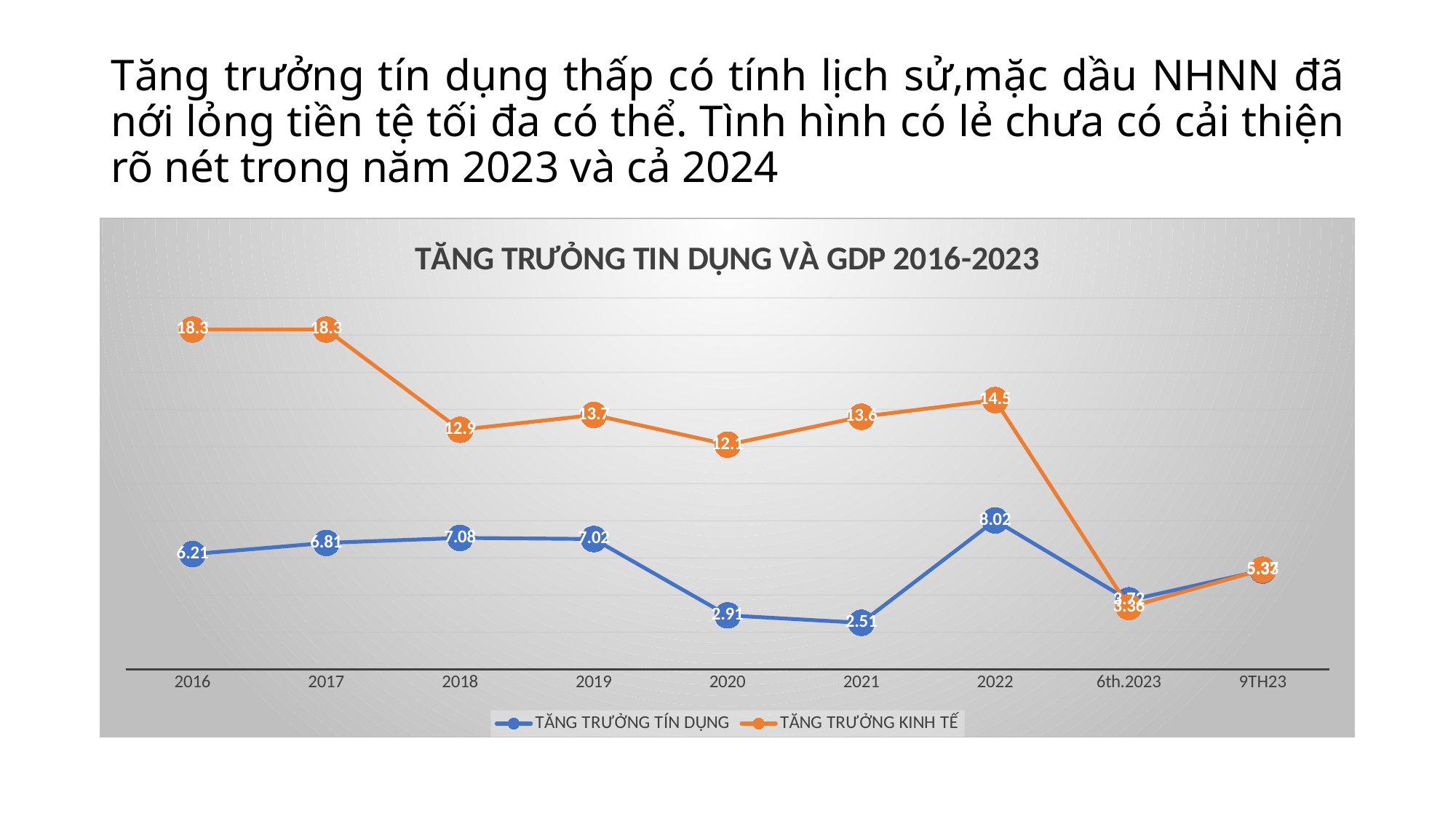
Which is larger, TĂNG TRƯỞNG TÍN DỤNG in 2018 or in 2019? 2018 How many series does the legend list? 2 In which category is TĂNG TRƯỞNG KINH TẾ lowest? 6th.2023 What kind of chart is shown on the slide? line chart What is the difference between TĂNG TRƯỞNG KINH TẾ and TĂNG TRƯỞNG TÍN DỤNG in 2022? 6.48 Does TĂNG TRƯỞNG KINH TẾ rise or fall from 2017 to 2018? fall What is the value of TĂNG TRƯỞNG TÍN DỤNG in 2021? 2.51 In which year does TĂNG TRƯỞNG TÍN DỤNG reach its highest value? 2022 What is the value of TĂNG TRƯỞNG TÍN DỤNG in 2016? 6.21 What is the value of TĂNG TRƯỞNG KINH TẾ in 2020? 12.1 What is the title of the chart? TĂNG TRƯỞNG TIN DỤNG VÀ GDP 2016-2023 How many categories are shown on the x axis? 9